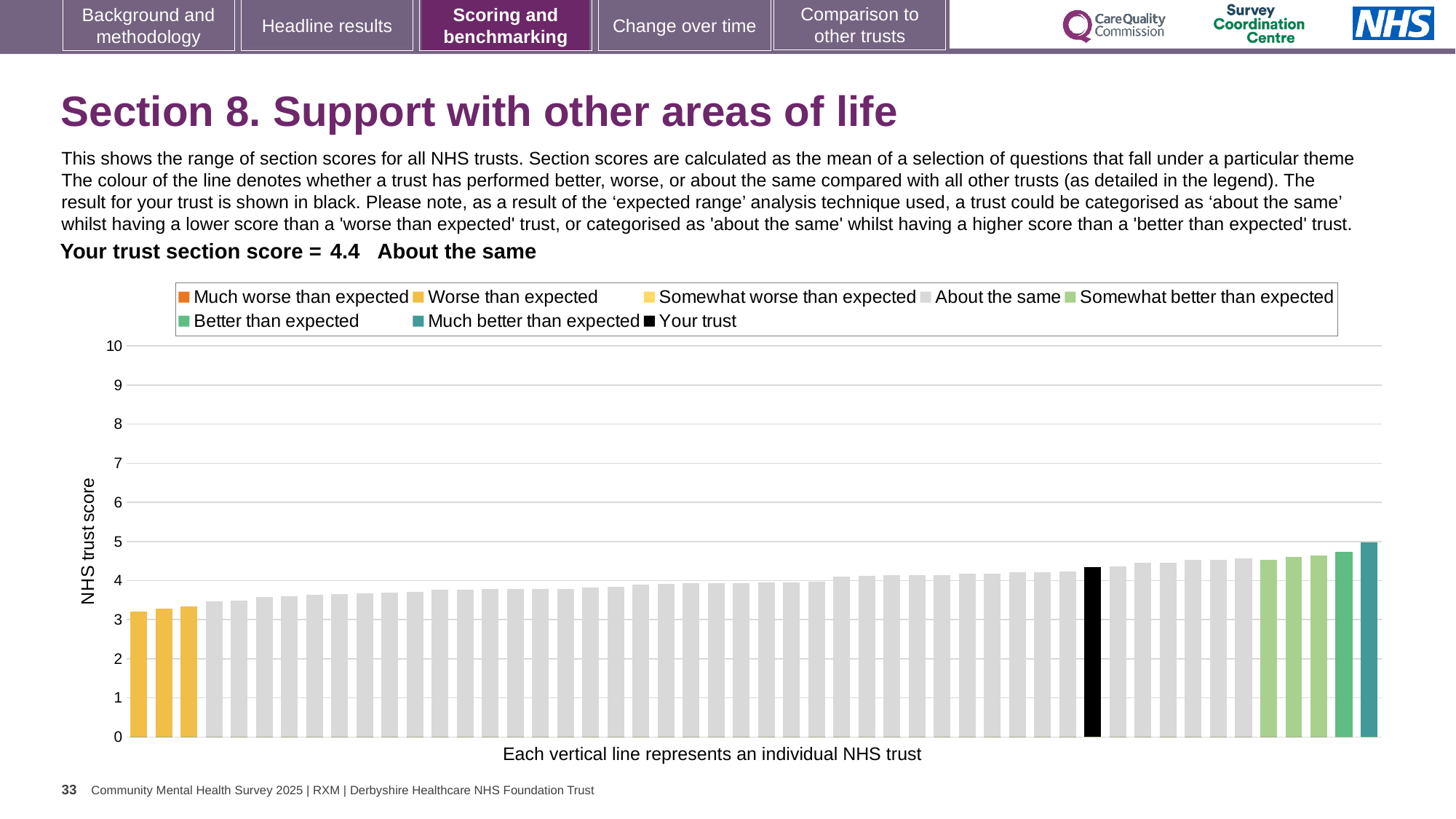
What colour is the bar representing your trust? black Is the value of the lowest bar greater or less than 4? less Which legend category does the highest (rightmost) bar belong to? Much better than expected Do the bar values rise or fall from left to right along the x axis? rise What is the label on the y axis of the chart? NHS trust score How many bars are coloured as 'Much better than expected'? 1 What is the section score for your trust? 4.4 Is the value of the black 'Your trust' bar greater or less than 4? greater Is the value of the highest bar greater or less than 4? greater Which category is your trust's section score placed in? About the same How many entries does the chart legend list? 8 What kind of chart is shown on the slide? bar chart